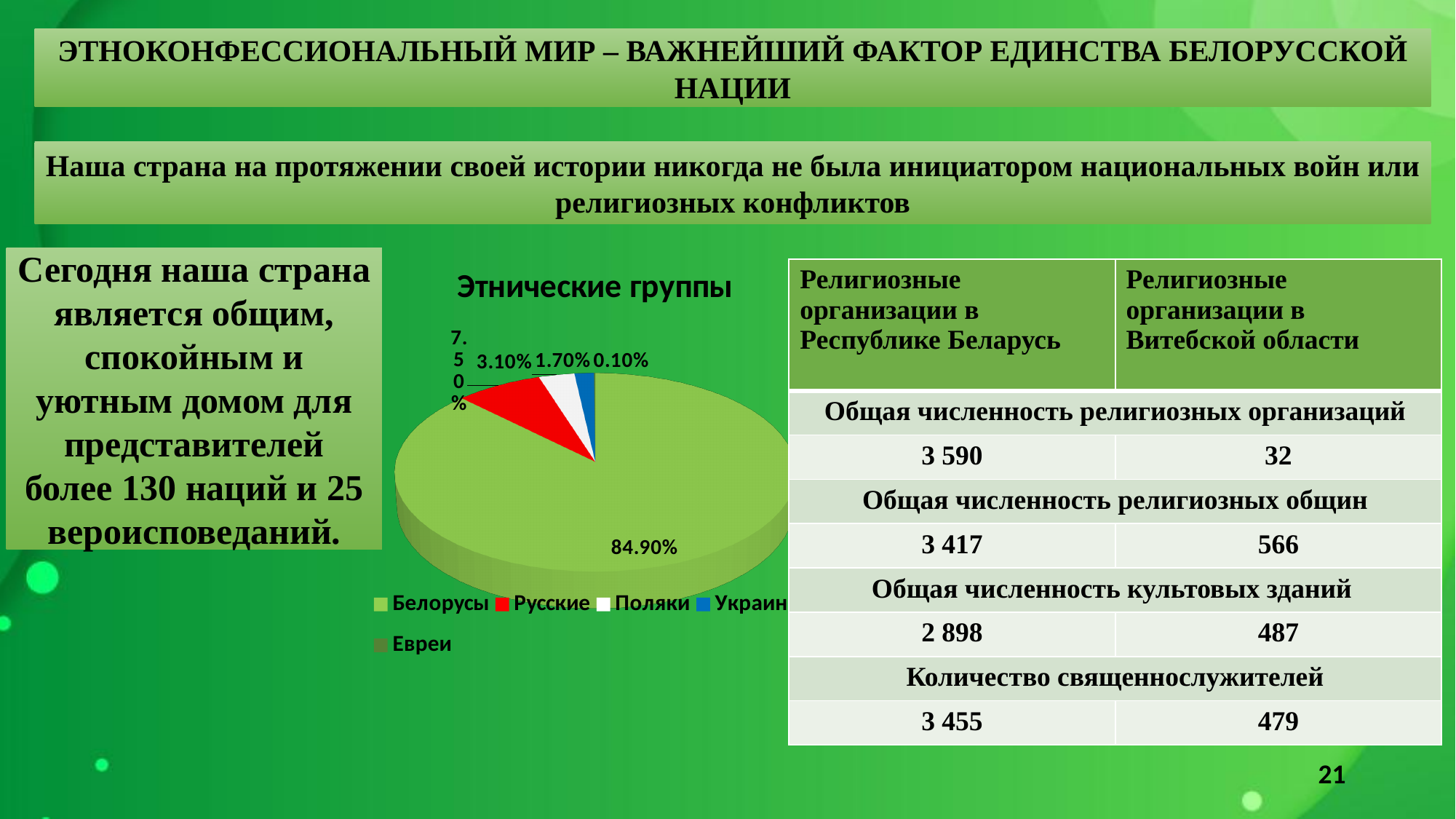
What is the value shown for Поляки in the pie chart? 3.10% Which slice is larger in the pie chart, Русские or Поляки? Русские How many ethnic groups does the legend of the pie chart list? 5 What kind of chart is used to show the ethnic groups (Этнические группы)? Pie chart What share of the pie chart do Белорусы account for? 84.90% What is the value shown for Русские in the pie chart? 7.50% What is the value shown for Евреи in the pie chart? 0.10% What is the title of the chart on the slide? Этнические группы What is the difference between the shares of Белорусы and Русские in the pie chart? 77.40% What colour is the slice for Русские in the pie chart? Red Which ethnic group has the smallest slice in the pie chart? Евреи Which ethnic group has the largest slice in the pie chart? Белорусы